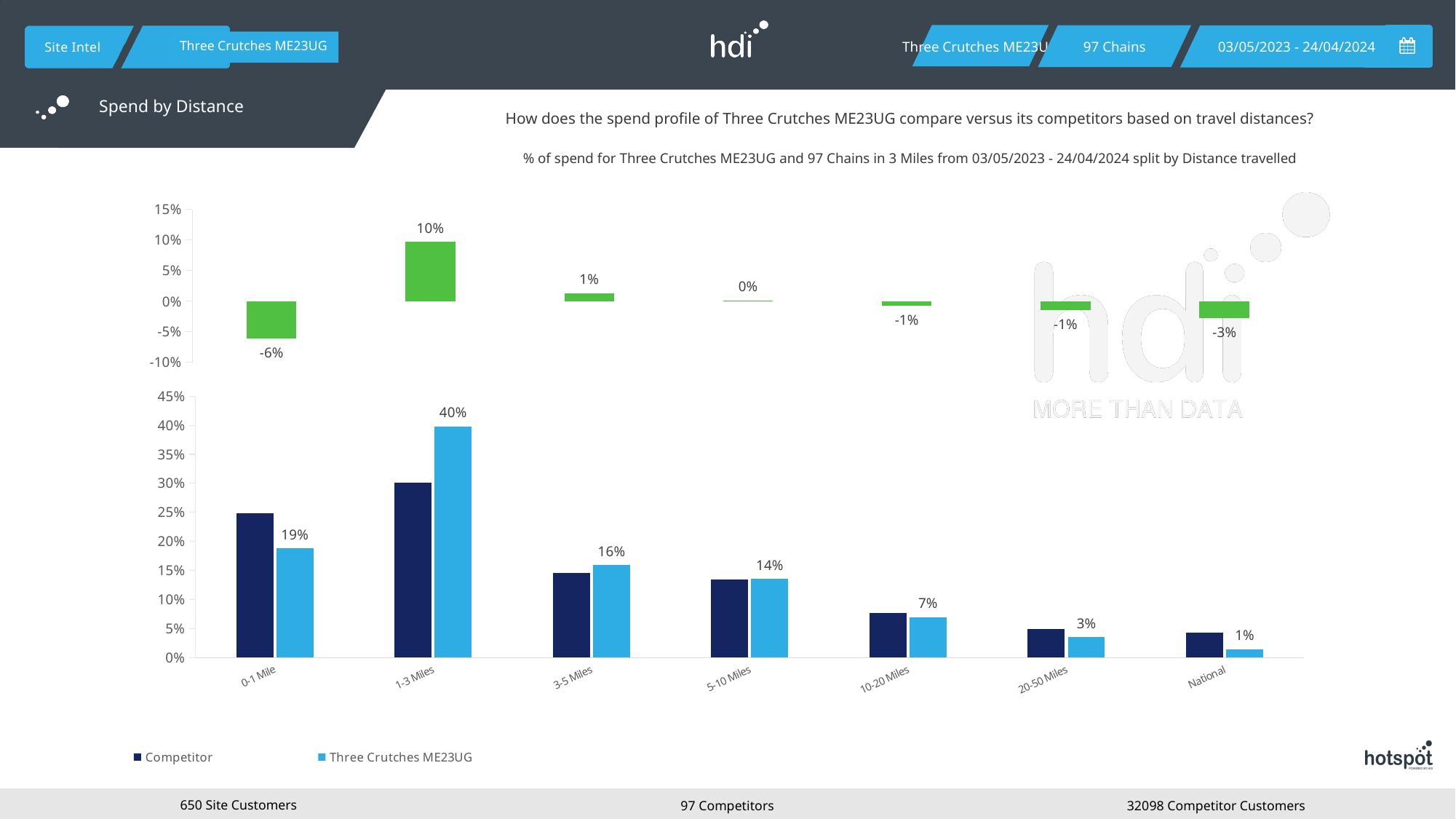
In the bottom chart, is the Competitor value for 1-3 Miles greater or less than 25%? greater How many series does the legend of the bottom chart list? 2 In the top chart, which distance band has the lowest value? 0-1 Mile In the bottom chart, what is the difference between the Three Crutches ME23UG values at 1-3 Miles and 0-1 Mile? 21% In the bottom chart at 0-1 Mile, which is larger: the Competitor bar or the Three Crutches ME23UG bar? Competitor In the bottom chart, which distance band has the highest Three Crutches ME23UG value? 1-3 Miles In the bottom chart, what is the value for Three Crutches ME23UG at 1-3 Miles? 40% In the bottom chart, what is the value for Three Crutches ME23UG at National? 1% In the top chart, what is the value shown for 0-1 Mile? -6% In the top chart, which distance band has the highest value? 1-3 Miles What type of chart is the bottom chart? Bar chart How many distance bands are shown on the x axis of the bottom chart? 7